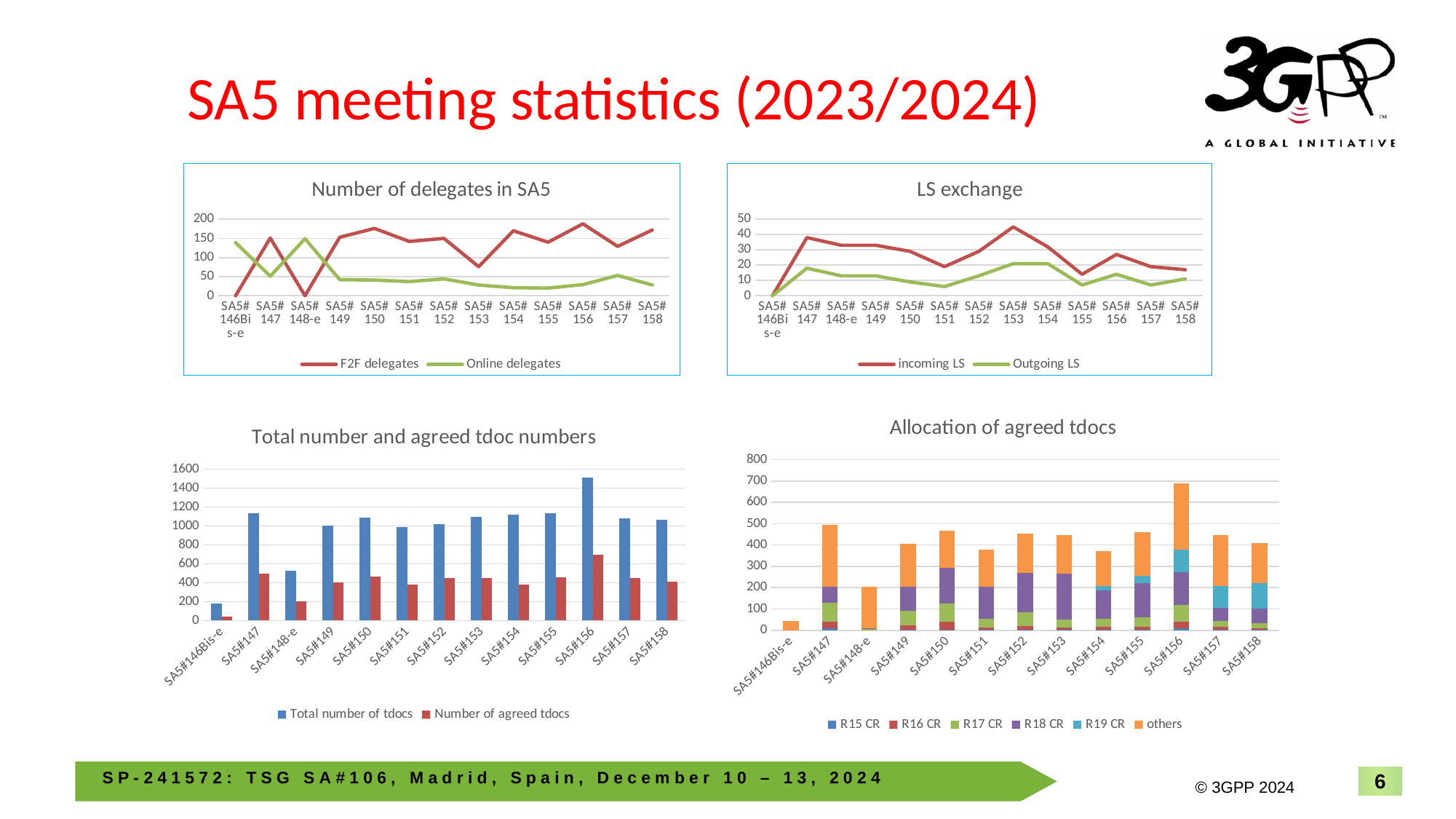
In the 'LS exchange' chart, at which meeting is the incoming LS value highest? SA5#153 In the 'Number of delegates in SA5' chart, is the F2F delegates value for SA5#156 greater or less than 150? greater In the 'Allocation of agreed tdocs' chart, which has the taller stacked bar, SA5#147 or SA5#148-e? SA5#147 In the 'LS exchange' chart, is the Outgoing LS value for SA5#151 greater or less than 10? less In the 'Total number and agreed tdoc numbers' chart, at which meeting is the Total number of tdocs highest? SA5#156 In the 'Number of delegates in SA5' chart, how many series does the legend list? 2 What kind of chart is the 'Total number and agreed tdoc numbers' chart? bar chart In the 'Total number and agreed tdoc numbers' chart, how many meetings are shown on the x axis? 13 In the 'Number of delegates in SA5' chart, is the Online delegates value for SA5#158 greater or less than 50? less In the 'Allocation of agreed tdocs' chart, how many series does the legend list? 6 What kind of chart is the 'LS exchange' chart? line chart In the 'Number of delegates in SA5' chart, at which meeting is the F2F delegates value highest? SA5#156